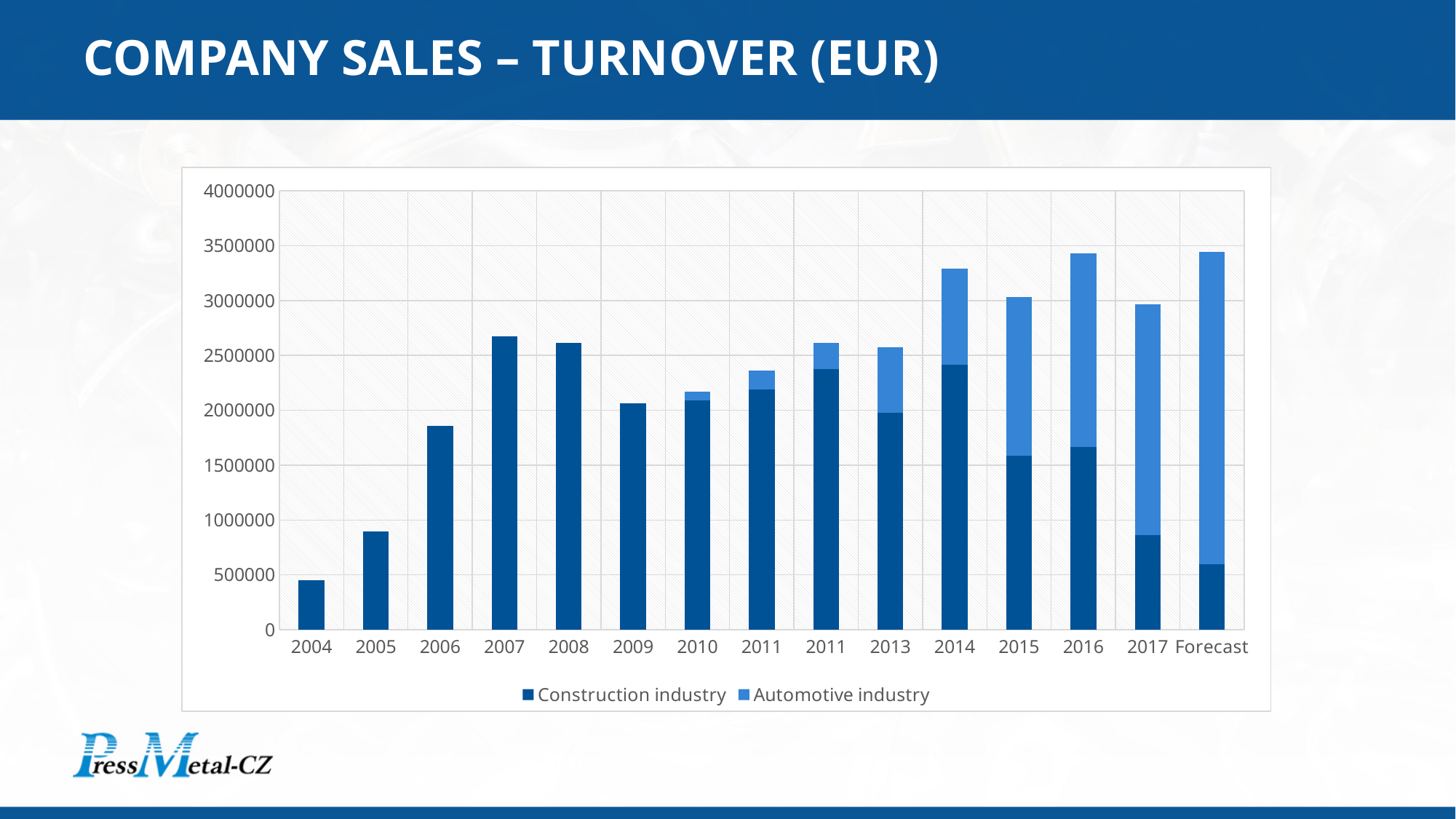
Is the Construction industry value for 2007 greater or less than 2500000? greater Does the Construction industry value rise or fall from 2014 to Forecast? fall Is the Construction industry value for 2017 greater or less than 1000000? less Is the Construction industry value for 2004 greater or less than 500000? less What is the title of the slide? COMPANY SALES – TURNOVER (EUR) Which is larger, the Construction industry value for 2014 or for 2015? 2014 How many series does the legend list? 2 What kind of chart is shown on the slide? Stacked bar chart Which is larger, the Automotive industry value for 2016 or for 2015? 2016 How many categories are shown along the x axis? 15 Which category has the lowest Construction industry value? 2004